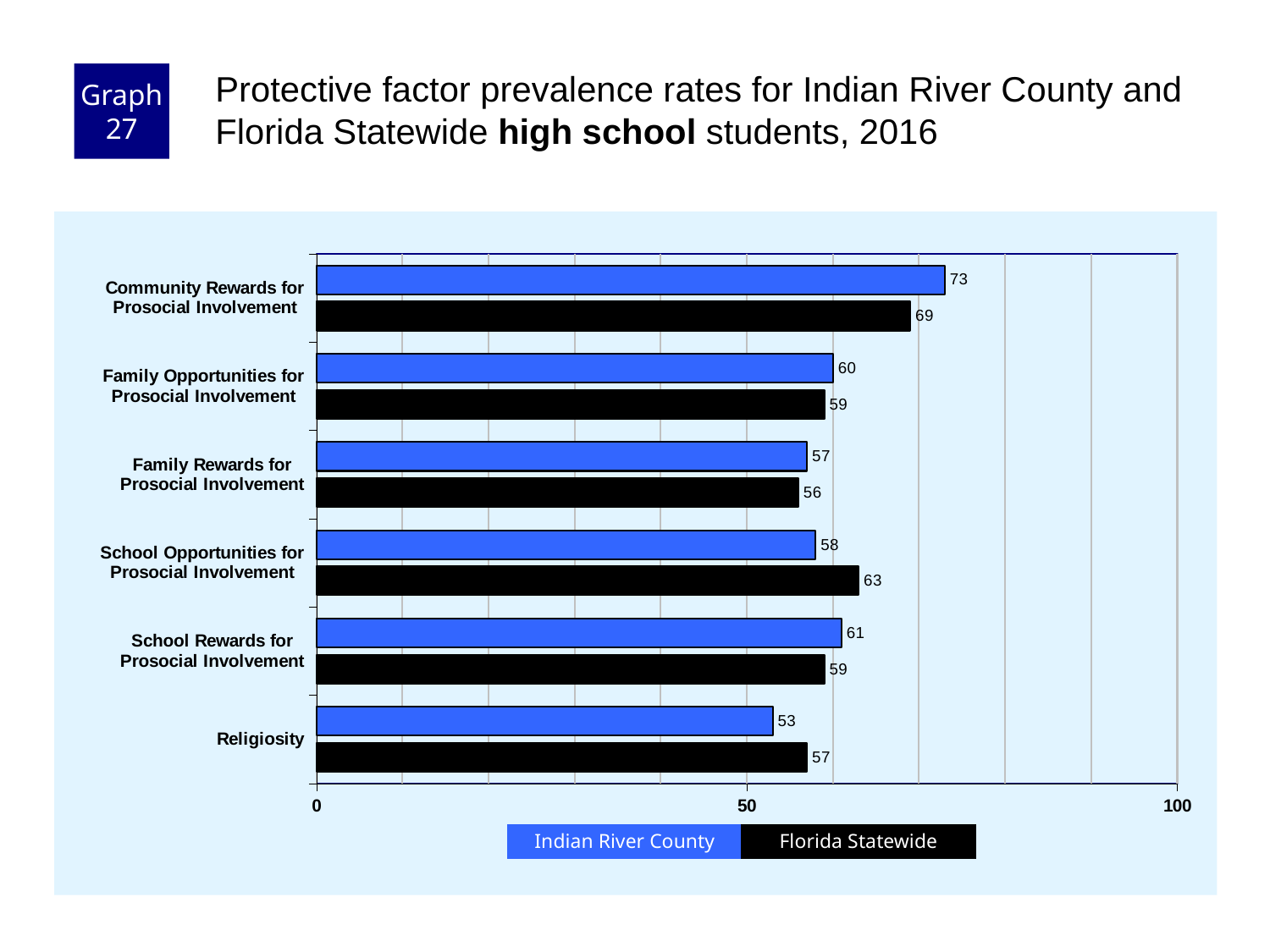
What is the Indian River County value for Religiosity? 53 What is the Indian River County value for Community Rewards for Prosocial Involvement? 73 How many series does the legend list? 2 Is the Florida Statewide value for Community Rewards for Prosocial Involvement greater or less than 50? greater What is the difference between the Indian River County and Florida Statewide values for Community Rewards for Prosocial Involvement? 4 Which category has the lowest Florida Statewide value? Family Rewards for Prosocial Involvement Which colour represents Florida Statewide in the chart? black How many categories are shown on the chart? 6 Which category has the highest Indian River County value? Community Rewards for Prosocial Involvement What kind of chart is shown on the slide? bar chart For Religiosity, which is larger: the Indian River County value or the Florida Statewide value? Florida Statewide What is the Florida Statewide value for School Opportunities for Prosocial Involvement? 63